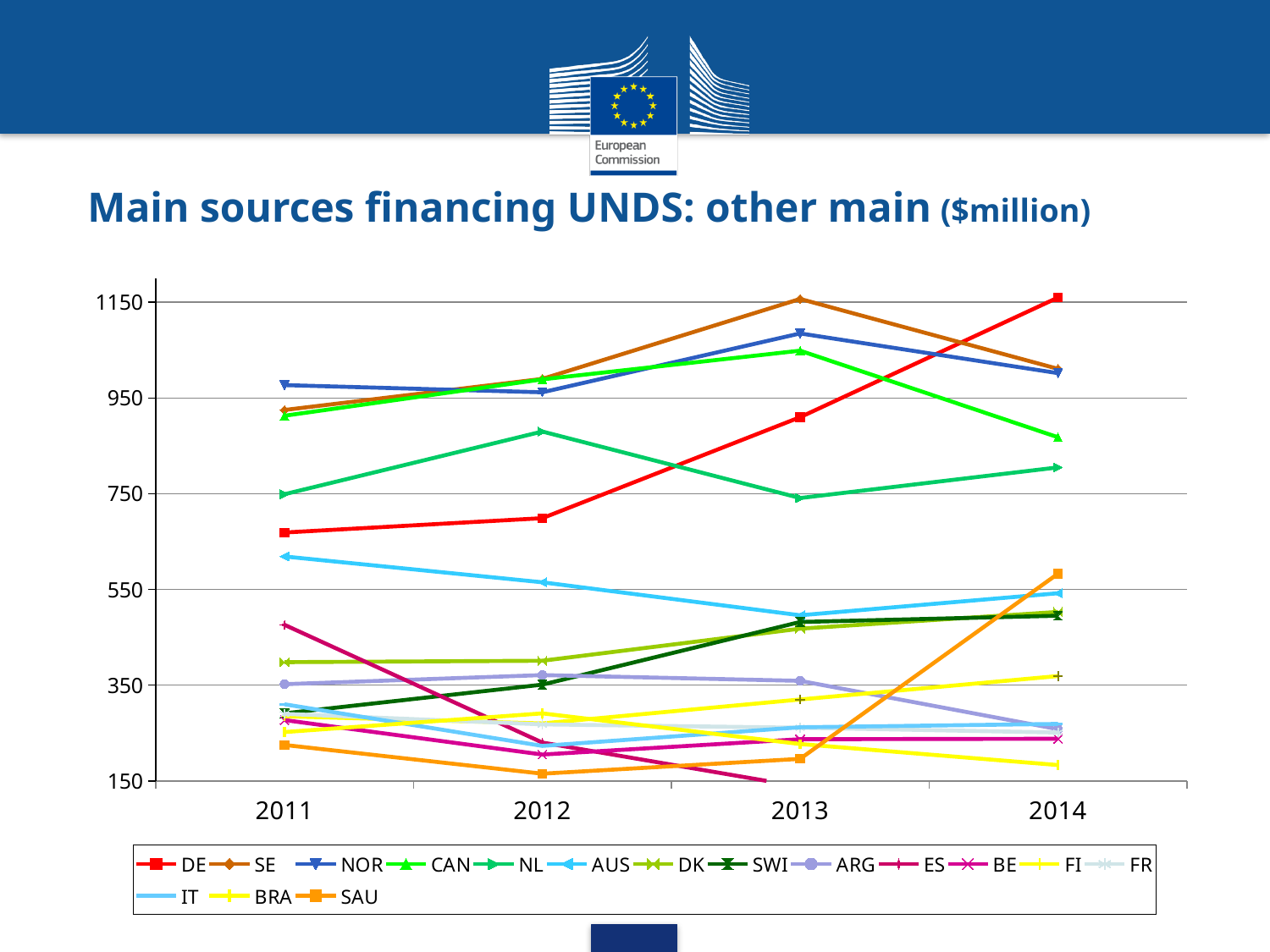
Is the value for NL in 2012 greater or less than 750? greater Which is larger in 2011, the value for NL or the value for AUS? NL Which series has the lowest value in 2012? SAU Is the value for CAN in 2014 greater or less than 950? less Is the value for DE in 2011 greater or less than 750? less How many series does the legend list? 16 Which series has the highest value in 2014? DE Does the value for DE rise or fall from 2011 to 2014? rise Which series has the highest value in 2013? SE What unit is given in the chart title? $million What kind of chart is shown on the slide? line chart How many years are shown along the x axis? 4